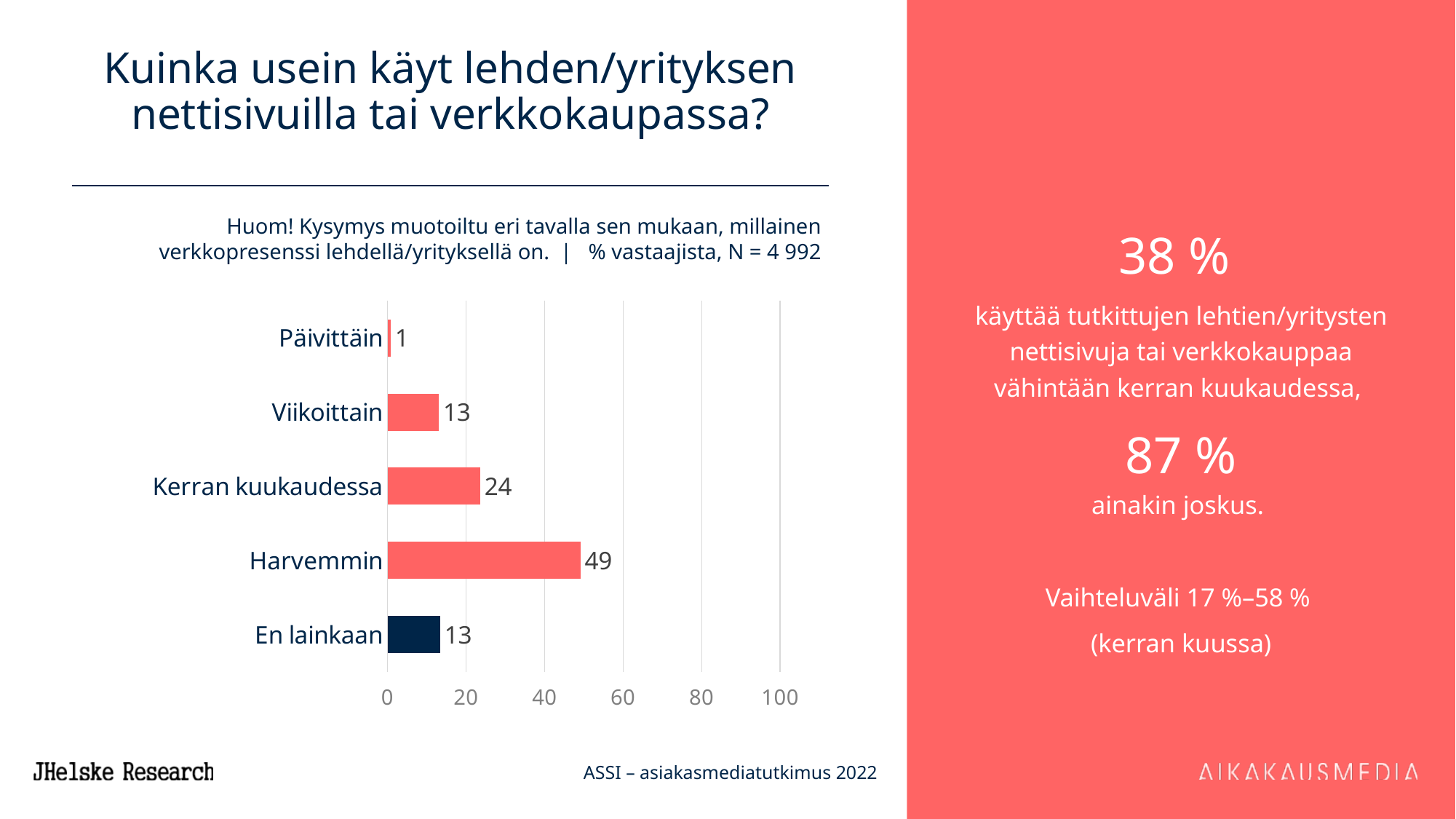
What is the value for Päivittäin? 1 Which is larger, the value for Viikoittain or the value for Kerran kuukaudessa? Kerran kuukaudessa What is the value for En lainkaan? 13 What is the value for Kerran kuukaudessa? 24 Is the value for Harvemmin greater or less than 40? greater What is the value for Harvemmin? 49 What is the difference between the values for Harvemmin and Kerran kuukaudessa? 25 How many categories are shown in the chart? 5 What kind of chart is shown on the slide? bar chart Which category's bar is coloured dark navy instead of red? En lainkaan Which category has the lowest value? Päivittäin Which category has the highest value? Harvemmin